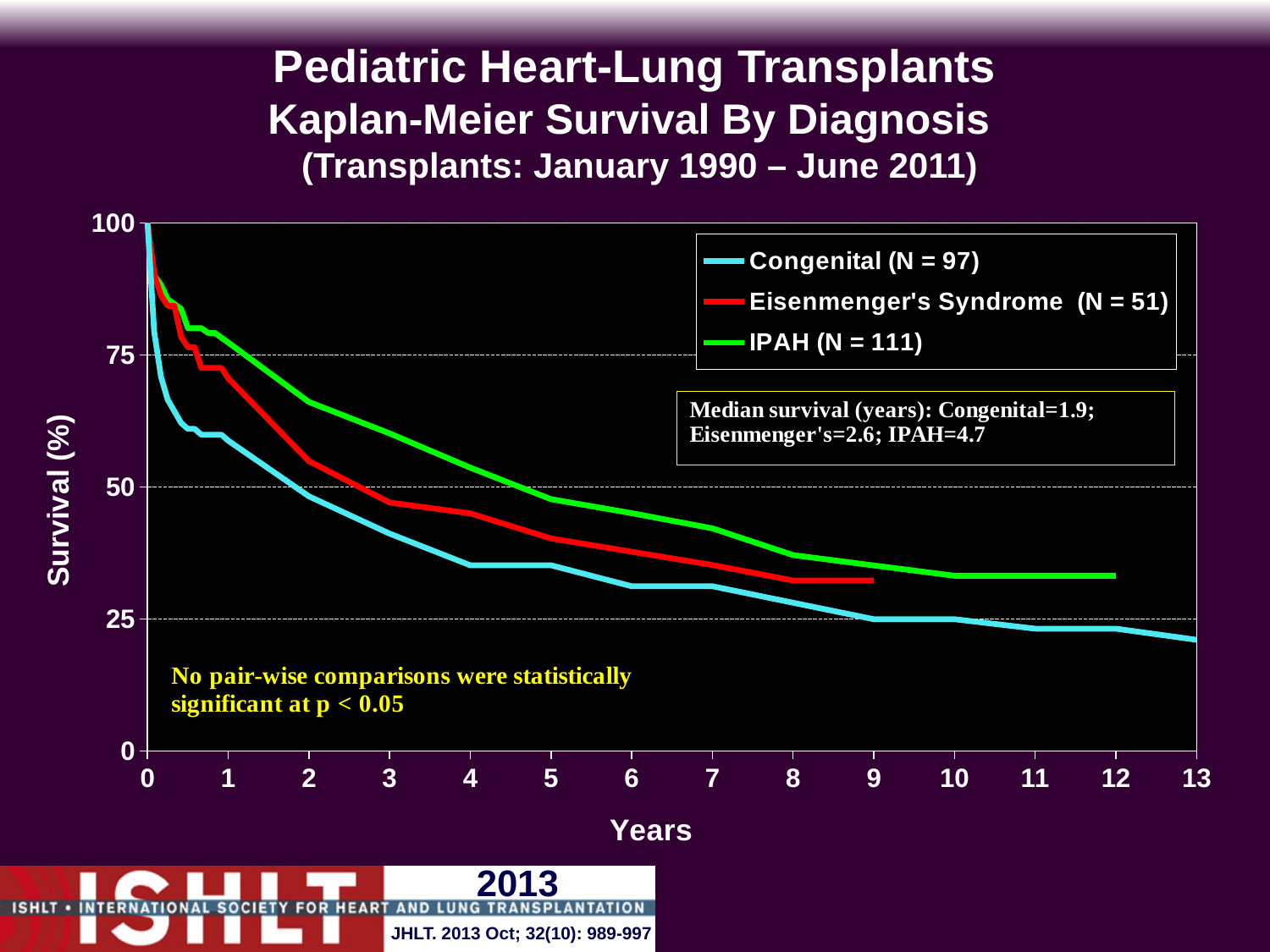
At 5 years, which curve shows higher survival: IPAH or Congenital? IPAH Is the survival value for the IPAH group at 2 years greater or less than 50? greater How many series does the legend list? 3 What is the median survival in years for the IPAH group? 4.7 How many patients (N) are in the Eisenmenger's Syndrome group according to the legend? 51 Which diagnosis group has the highest median survival? IPAH Which diagnosis group has the lowest median survival? Congenital Is the survival value for the Congenital group at 5 years greater or less than 50? less What is the median survival in years for the Congenital group? 1.9 Do the survival curves rise or fall as years increase? Fall What is the difference in median survival (years) between the IPAH and Congenital groups? 2.8 What kind of chart is shown on the slide? Line chart